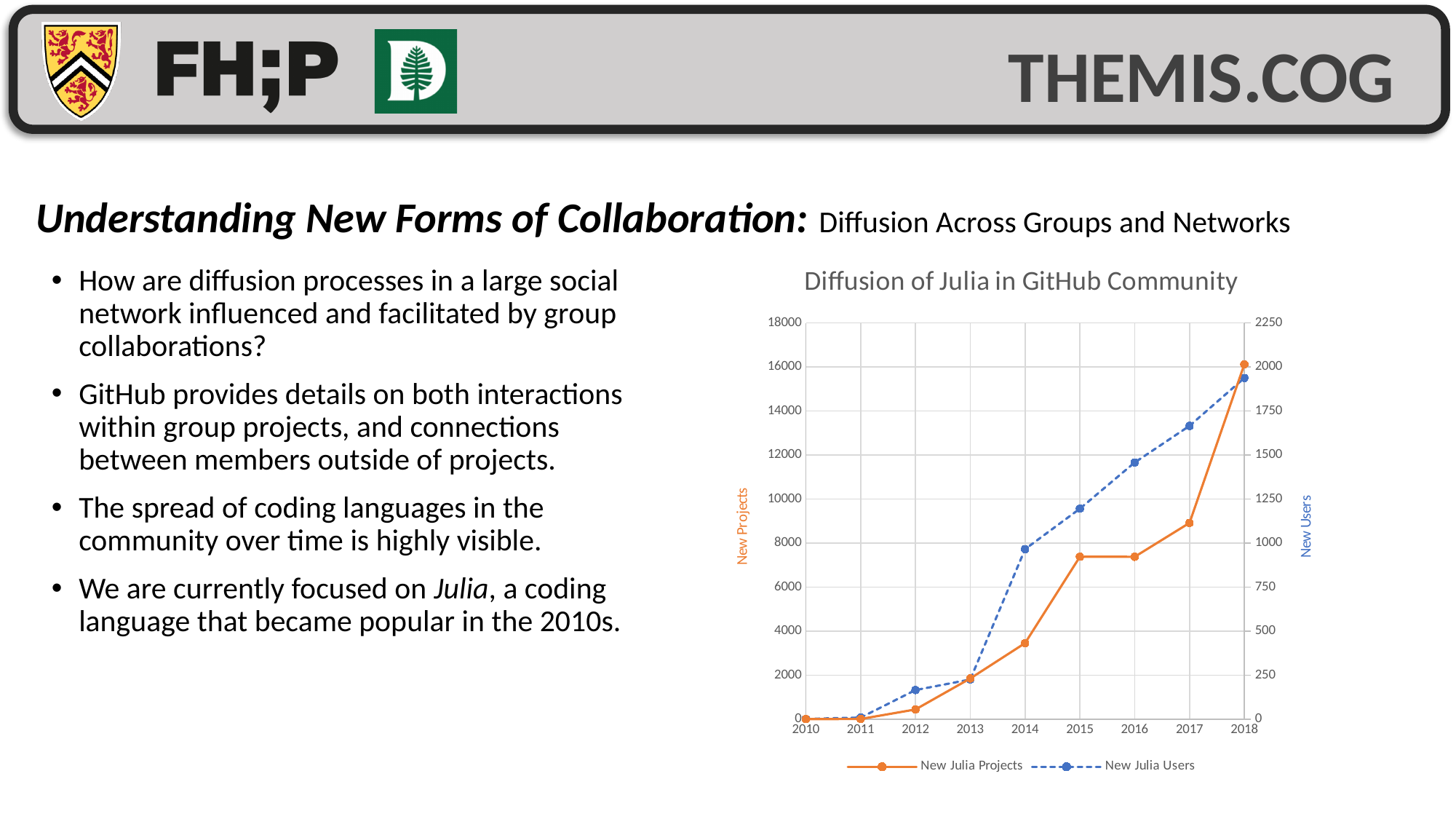
How many years are plotted along the x axis of the chart? 9 Is the value for New Julia Users in 2014 greater or less than 1000? less Is the value for New Julia Projects in 2015 greater or less than 8000? less In which year is the value for New Julia Projects highest? 2018 Is the value for New Julia Projects in 2018 greater or less than 14000? greater How many series does the chart's legend list? 2 What is the title of the chart? Diffusion of Julia in GitHub Community Which is larger for New Julia Projects: the value in 2017 or the value in 2018? 2018 What kind of chart is shown on the slide? line chart Do the values for New Julia Users generally rise or fall from 2010 to 2018? rise